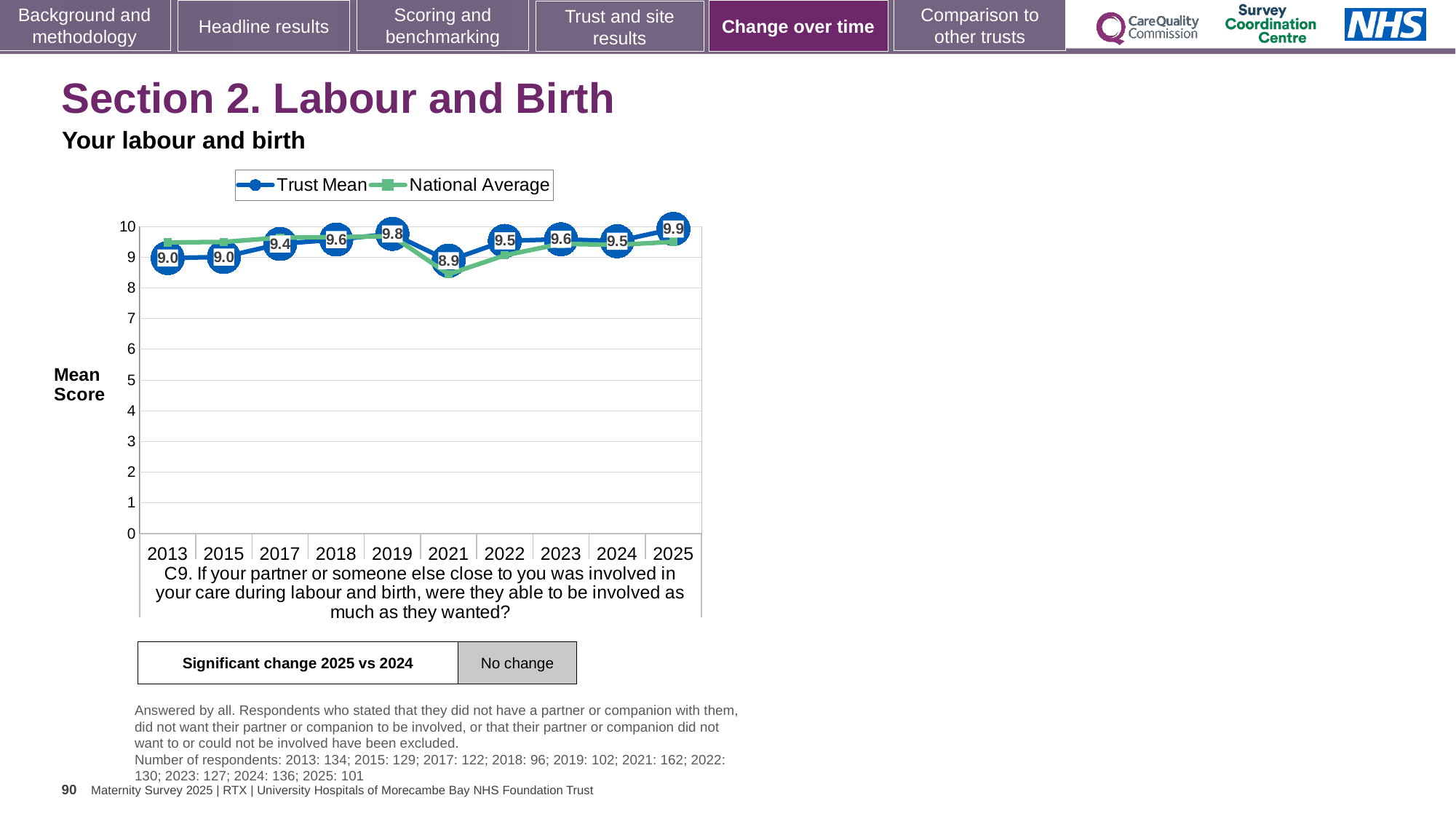
In which year is the Trust Mean score lowest? 2021 Which is larger, the Trust Mean score for 2019 or for 2022? 2019 What is the label of the y axis? Mean Score What type of chart is shown on the slide? Line chart Is the National Average value for 2021 greater or less than 9? less What is the Trust Mean score for 2019? 9.8 In which year is the Trust Mean score highest? 2025 What is the Trust Mean score for 2025? 9.9 How many years are plotted on the x axis? 10 What is the difference between the Trust Mean scores for 2025 and 2021? 1.0 How many series does the legend list? 2 What is the Trust Mean score for 2021? 8.9